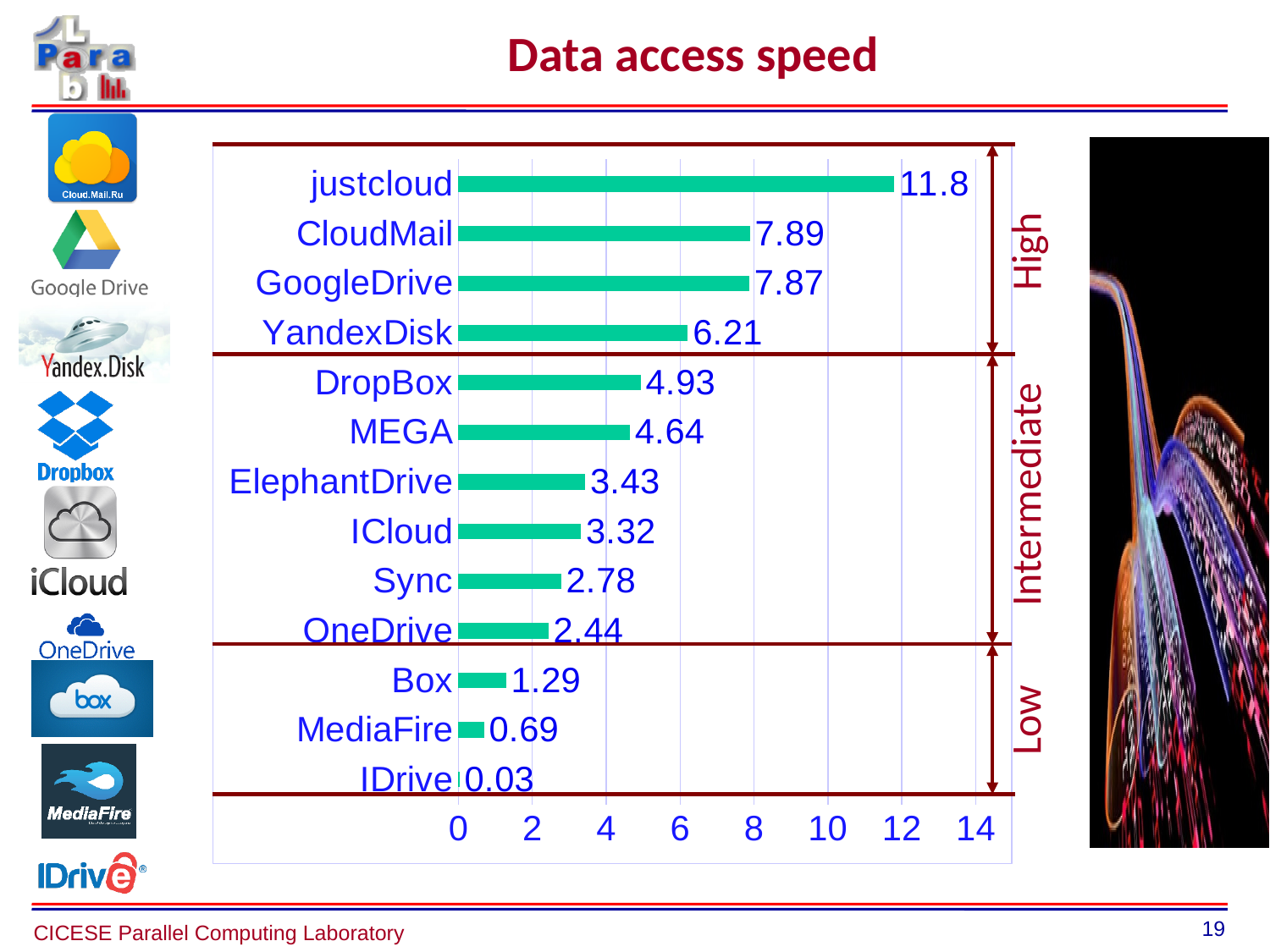
How many services are plotted in the chart? 13 Which group label is assigned to the bars for Box, MediaFire and IDrive? Low What is the difference between the values for DropBox and MEGA? 0.29 Which service has the lowest data access speed? IDrive Which has a larger value, ElephantDrive or Sync? ElephantDrive Which service has the highest data access speed? justcloud What kind of chart is shown on the slide? bar chart What is the value shown for MediaFire? 0.69 What is the data access speed value for justcloud? 11.8 What is the value shown for YandexDisk? 6.21 What is the difference between the values for justcloud and CloudMail? 3.91 Is the value for GoogleDrive greater or less than 6? greater